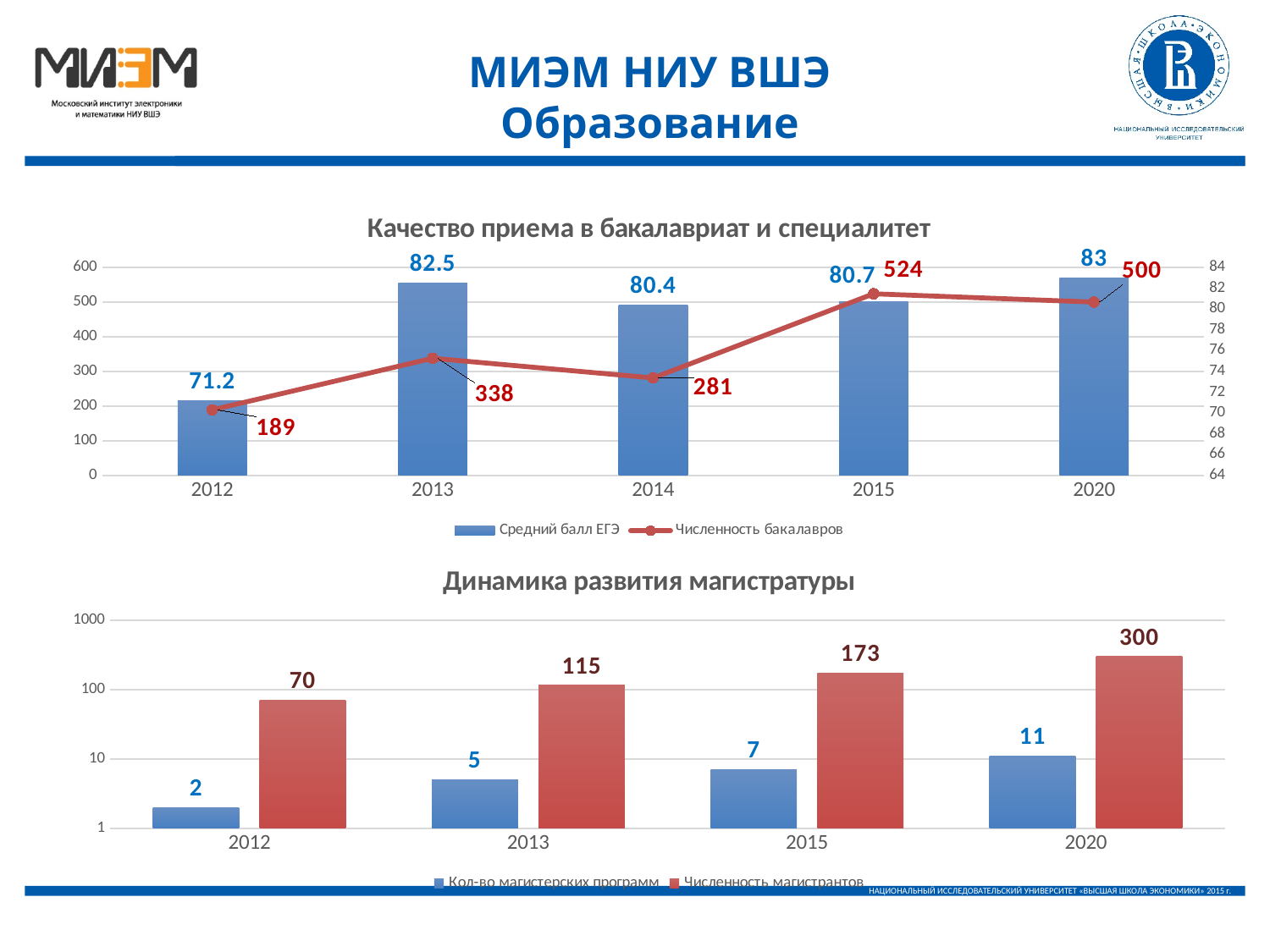
In the chart 'Качество приема в бакалавриат и специалитет', which year has the lowest Средний балл ЕГЭ? 2012 In the chart 'Динамика развития магистратуры', what is the value of Кол-во магистерских программ for 2020? 11 In the chart 'Качество приема в бакалавриат и специалитет', what is the difference in Численность бакалавров between 2013 and 2014? 57 In the chart 'Динамика развития магистратуры', what is the value of Численность магистрантов for 2015? 173 In the chart 'Качество приема в бакалавриат и специалитет', which year has the highest Численность бакалавров? 2015 In the chart 'Качество приема в бакалавриат и специалитет', what is the value of Средний балл ЕГЭ for 2013? 82.5 In the chart 'Качество приема в бакалавриат и специалитет', how many years are shown on the x axis? 5 In the chart 'Динамика развития магистратуры', do the values of Кол-во магистерских программ rise or fall from 2012 to 2020? rise What kind of chart is 'Динамика развития магистратуры'? bar chart In the chart 'Динамика развития магистратуры', what is the difference in Численность магистрантов between 2020 and 2012? 230 In the chart 'Качество приема в бакалавриат и специалитет', how many series does the legend list? 2 In the chart 'Качество приема в бакалавриат и специалитет', what is the value of Численность бакалавров for 2015? 524